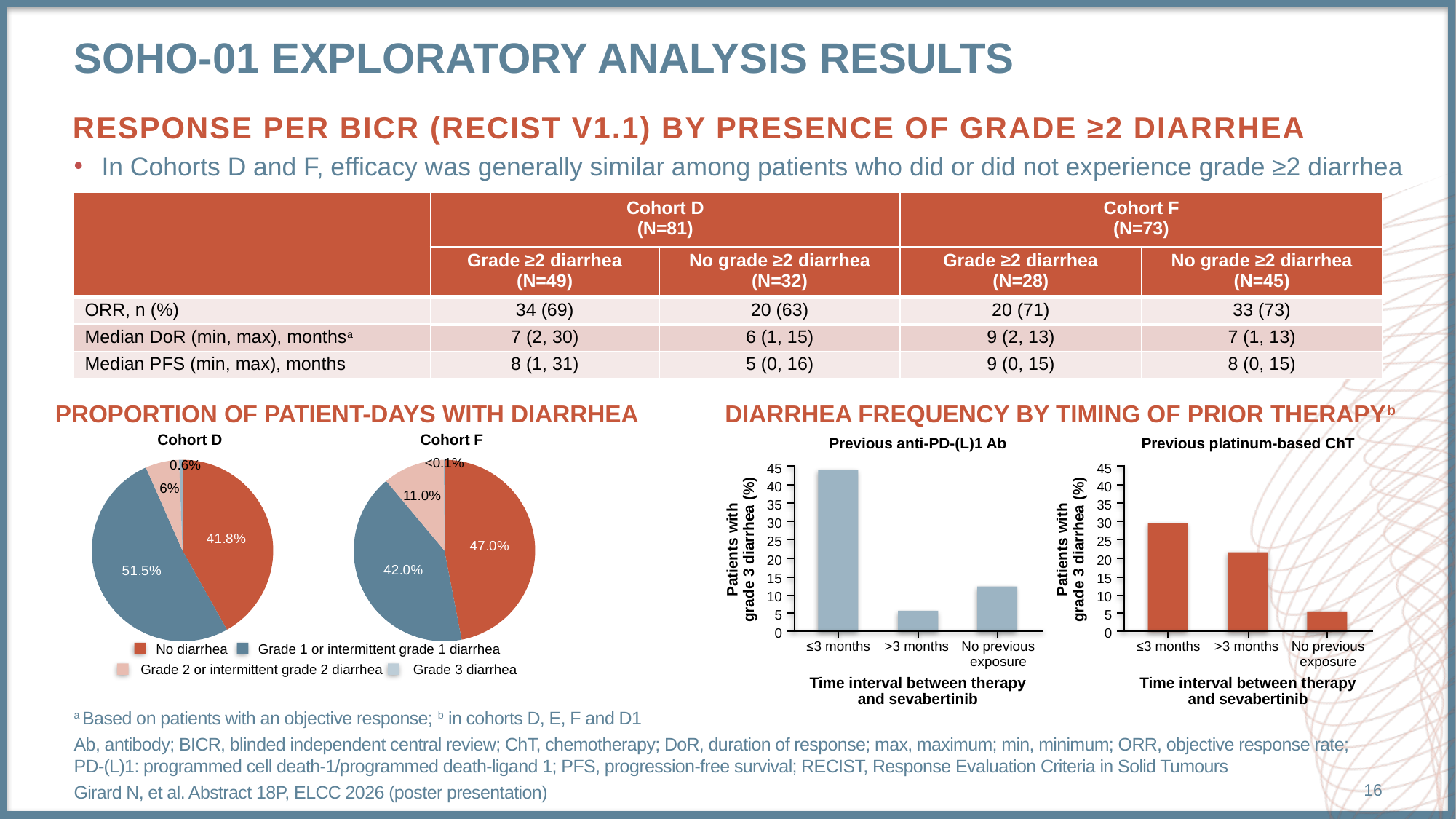
In the Previous platinum-based ChT bar chart, is the value for >3 months greater or less than 25? less In the Previous anti-PD-(L)1 Ab bar chart, which time interval has the highest percentage of patients with grade 3 diarrhea? ≤3 months In the Cohort D pie chart, which category has the largest share? Grade 1 or intermittent grade 1 diarrhea In the Cohort F pie chart, which category has the largest share? No diarrhea In the Previous anti-PD-(L)1 Ab bar chart, is the value for ≤3 months greater or less than 40? greater In the Cohort F pie chart, which category has the smallest share? Grade 3 diarrhea In the Cohort F pie chart, what percentage of patient-days had grade 2 or intermittent grade 2 diarrhea? 11.0% What kind of chart is the Previous platinum-based ChT chart? bar chart In the Cohort D pie chart, what percentage of patient-days had no diarrhea? 41.8% In the Cohort D pie chart, how many percentage points larger is the Grade 1 or intermittent grade 1 diarrhea slice than the No diarrhea slice? 9.7 percentage points How many time interval categories are shown in the Previous anti-PD-(L)1 Ab bar chart? 3 In the Previous platinum-based ChT bar chart, which time interval has the lowest percentage of patients with grade 3 diarrhea? No previous exposure